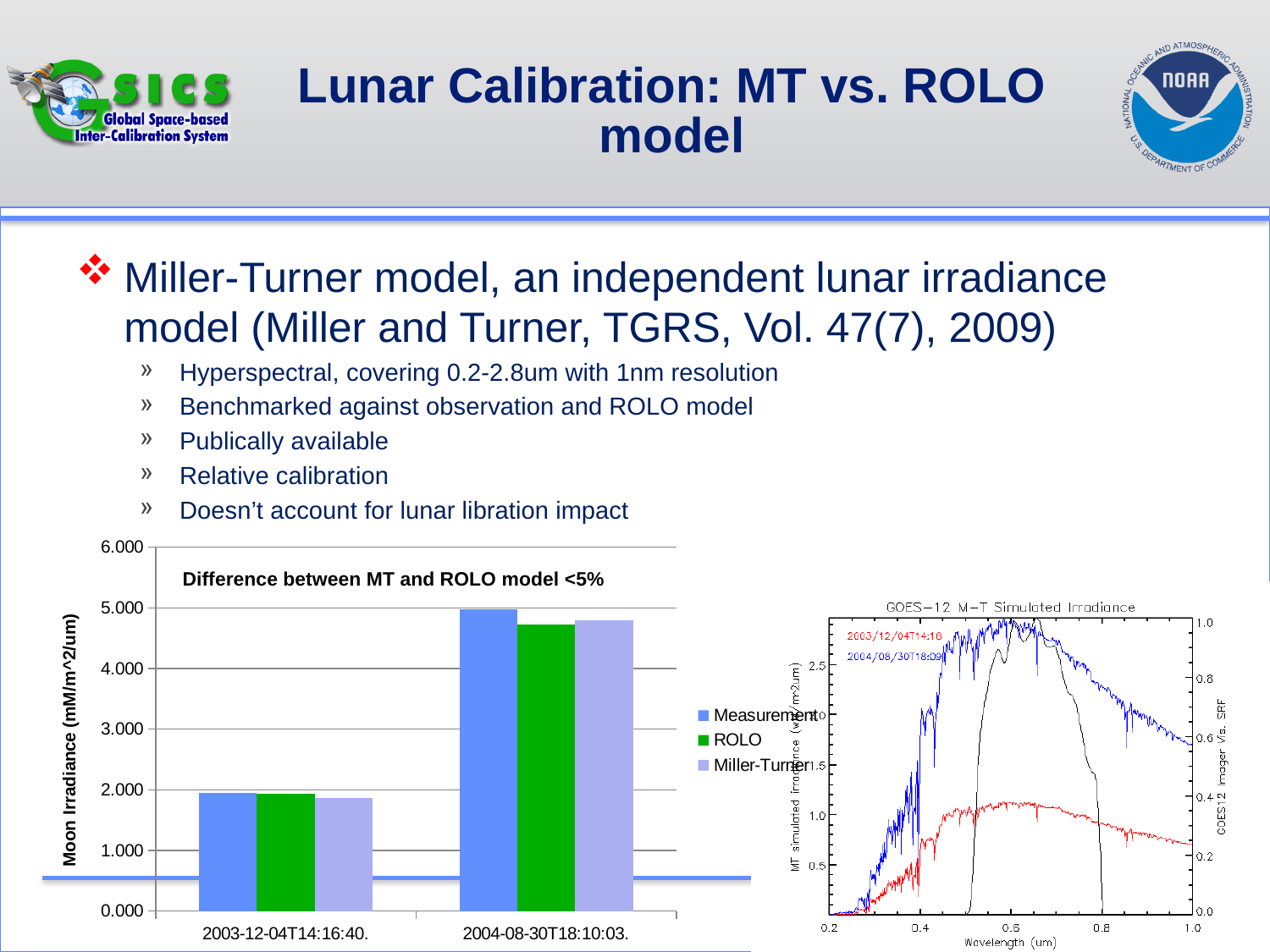
In the bar chart on the left, is the ROLO value for 2004-08-30T18:10:03. greater or less than 5.000? less In the bar chart on the left, what text annotation is printed inside the plot area above the bars? Difference between MT and ROLO model <5% In the bar chart on the left, which category has the higher Measurement value, 2003-12-04T14:16:40. or 2004-08-30T18:10:03.? 2004-08-30T18:10:03. What kind of chart is the chart on the left of the slide with the y axis labelled Moon Irradiance? bar chart What is the title of the line chart on the right of the slide? GOES-12 M-T Simulated Irradiance In the bar chart on the left, how many series does the legend list? 3 In the bar chart on the left, how many categories are shown on the x axis? 2 In the bar chart on the left, is the Measurement value for 2004-08-30T18:10:03. greater or less than 4.000? greater In the line chart on the right, is the peak of the 2004/08/30T18:09 curve greater or less than 1.5 on the left axis? less In the line chart on the right, which date's curve reaches higher irradiance values, 2003/12/04T14:16 or 2004/08/30T18:09? 2003/12/04T14:16 In the bar chart on the left, which series does the green bar represent? ROLO